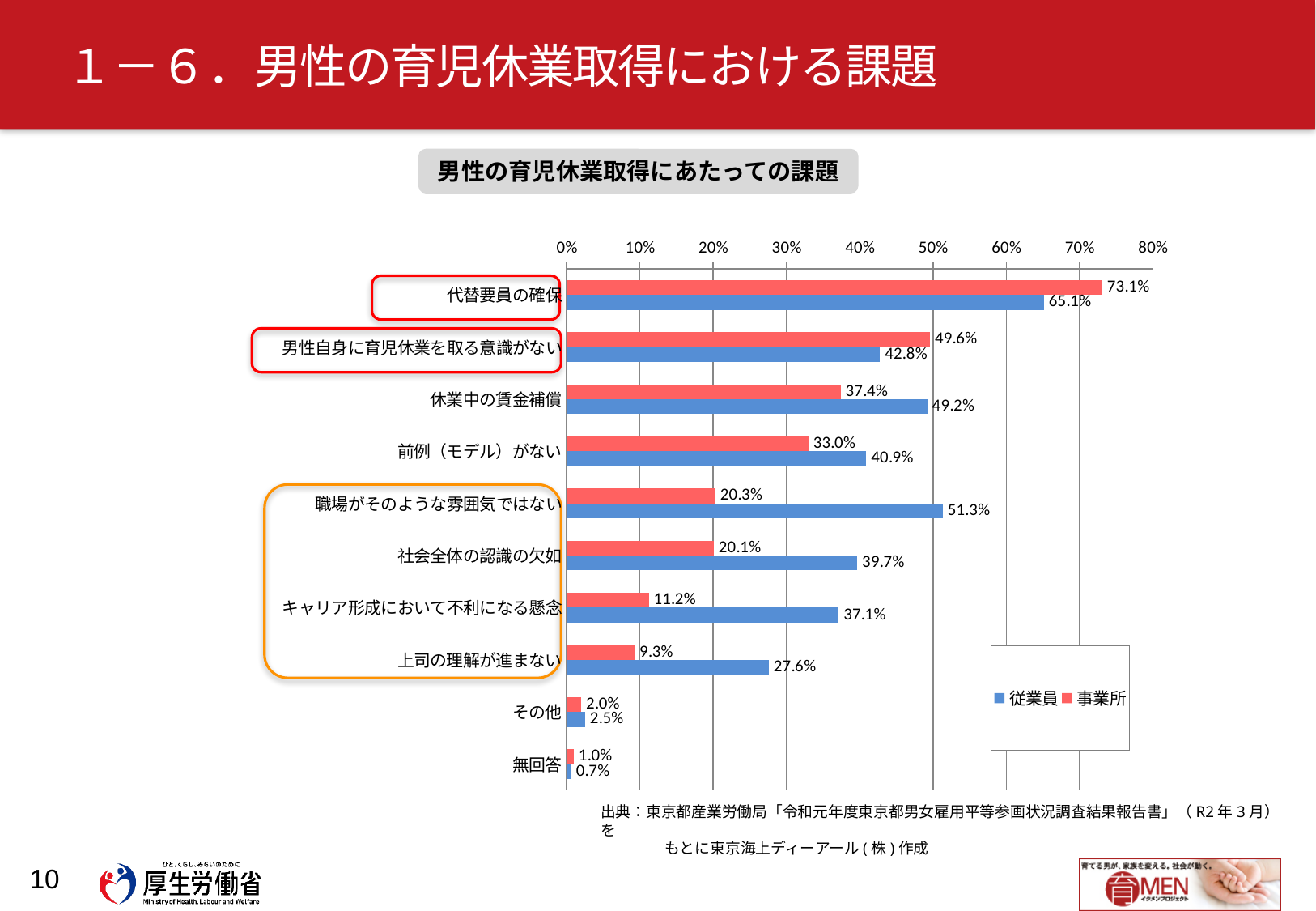
How many series does the legend list? 2 What is the difference between the 従業員 and 事業所 values for 職場がそのような雰囲気ではない? 31.0% For 休業中の賃金補償, which is larger: the 従業員 value or the 事業所 value? 従業員 What is the 従業員 value for 職場がそのような雰囲気ではない? 51.3% Which colour represents the 事業所 series in the chart? red What type of chart is shown on the slide? bar chart What is the 事業所 value for 代替要員の確保? 73.1% What is the difference between the 事業所 and 従業員 values for 代替要員の確保? 8.0% How many categories are plotted in the chart? 10 Which category has the highest 事業所 value? 代替要員の確保 What is the 従業員 value for キャリア形成において不利になる懸念? 37.1% Which category has the lowest 従業員 value? 無回答